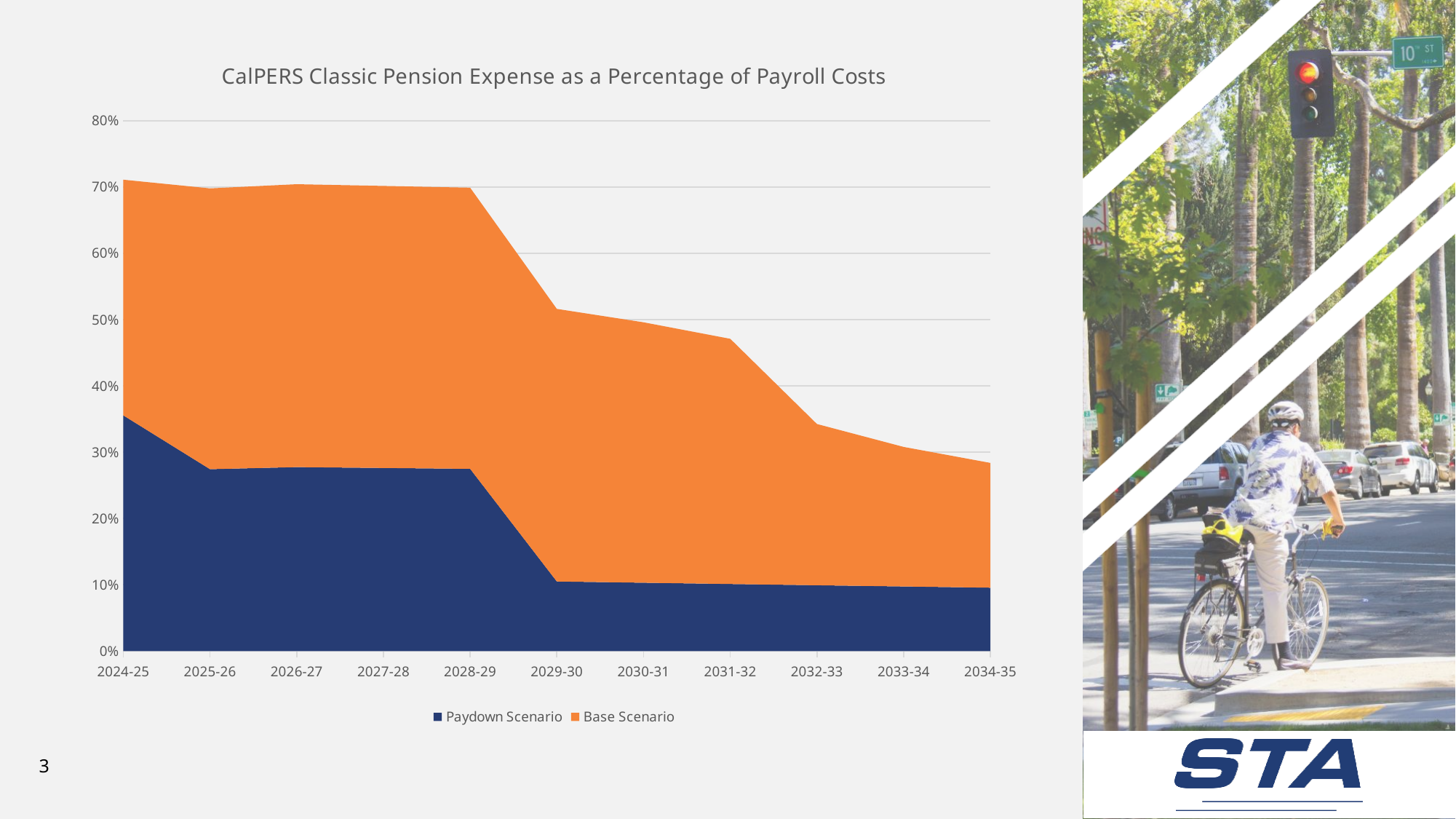
Is the top of the stacked area for 2032-33 greater or less than 30%? greater Is the Paydown Scenario value for 2024-25 greater or less than 30%? greater Is the Paydown Scenario value for 2030-31 greater or less than 20%? less How many fiscal years are shown along the x axis? 11 How many series does the legend list? 2 Which series is shown in dark blue? Paydown Scenario What is the title of the chart? CalPERS Classic Pension Expense as a Percentage of Payroll Costs What kind of chart is shown on the slide? Stacked area chart Does the Paydown Scenario value generally rise or fall from 2024-25 to 2034-35? fall In which fiscal year is the Paydown Scenario value highest? 2024-25